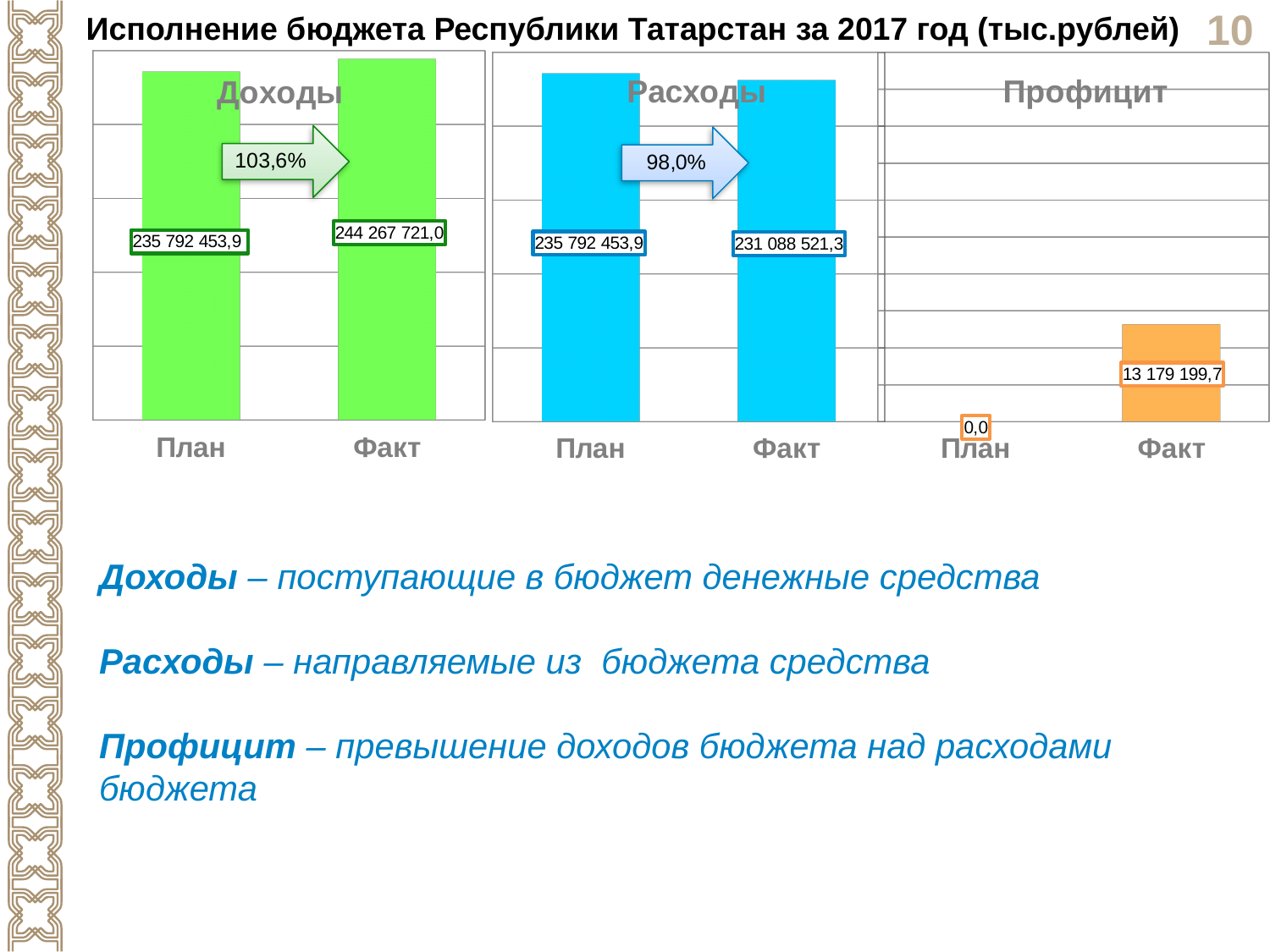
In the Доходы chart, which is larger, План or Факт? Факт What percentage is shown on the arrow in the Расходы chart? 98,0% In the Профицит chart, what is the value for План? 0,0 What kind of chart is the Профицит chart? Bar chart In the Доходы chart, what is the value for Факт? 244 267 721,0 In the Доходы chart, what is the difference between Факт and План? 8 475 267,1 In the Доходы chart, what is the value for План? 235 792 453,9 In the Расходы chart, which category has the lowest value? Факт In the Расходы chart, what is the difference between План and Факт? 4 703 932,6 In the Расходы chart, what is the value for Факт? 231 088 521,3 In the Профицит chart, what is the value for Факт? 13 179 199,7 How many categories does the Расходы chart show? 2